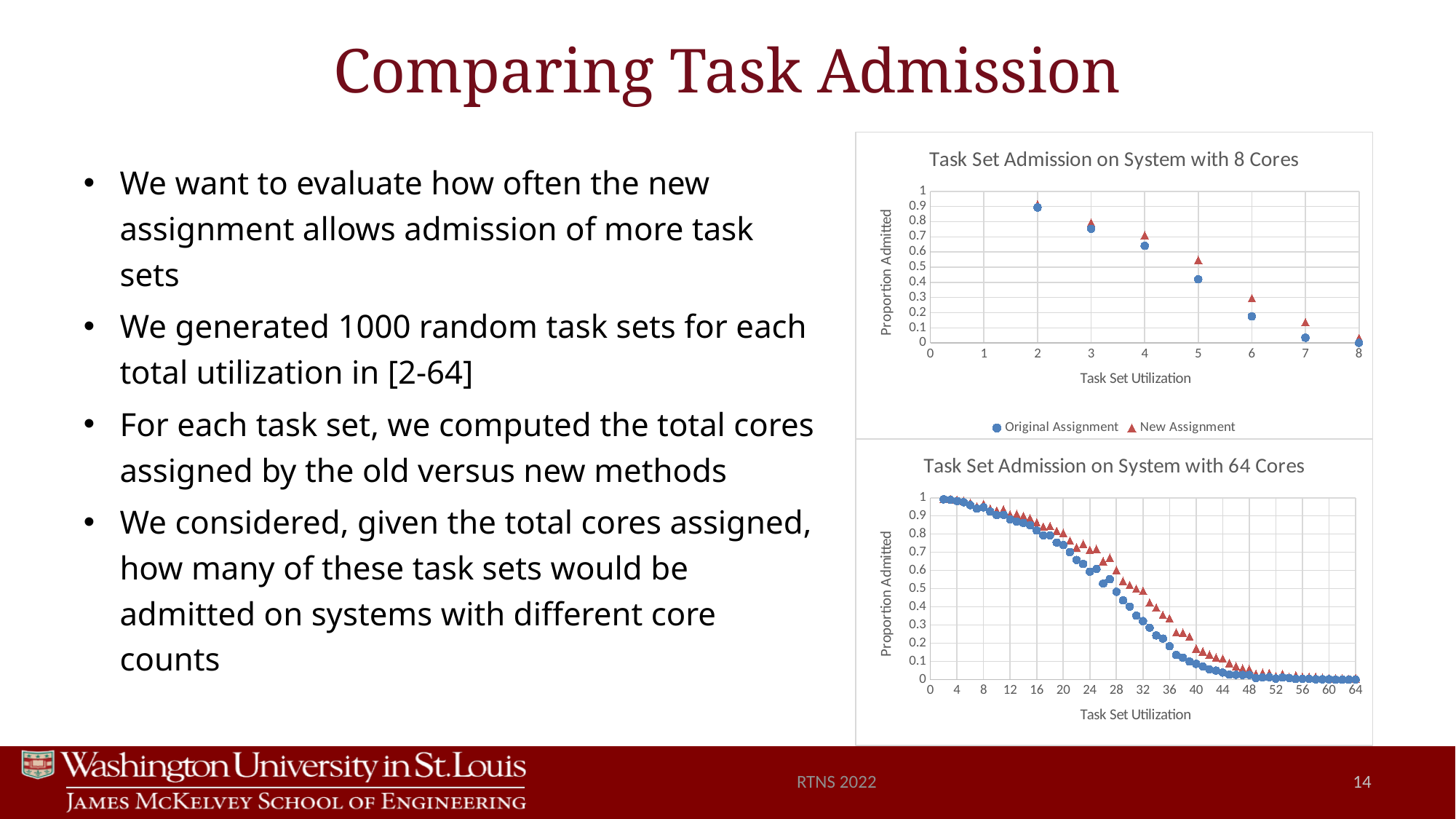
In the 'Task Set Admission on System with 8 Cores' chart, which series has the higher proportion admitted at task set utilization 5? New Assignment In the 'Task Set Admission on System with 8 Cores' chart, do the Original Assignment values rise or fall as task set utilization increases? fall In the 'Task Set Admission on System with 8 Cores' chart, how many task set utilization values are plotted for the Original Assignment series? 7 In the 'Task Set Admission on System with 8 Cores' chart, is the Original Assignment value at task set utilization 4 greater or less than 0.5? greater In the 'Task Set Admission on System with 8 Cores' chart, at which task set utilization is the Original Assignment proportion admitted highest? 2 In the 'Task Set Admission on System with 8 Cores' chart, is the Original Assignment value at task set utilization 5 greater or less than 0.5? less In the 'Task Set Admission on System with 8 Cores' chart, is the New Assignment value at task set utilization 6 greater or less than 0.2? greater What is the x-axis title of the 'Task Set Admission on System with 64 Cores' chart? Task Set Utilization In the 'Task Set Admission on System with 64 Cores' chart, do the values rise or fall as task set utilization increases? fall What kind of chart is the 'Task Set Admission on System with 8 Cores' chart? scatter chart How many series does the legend of the 'Task Set Admission on System with 8 Cores' chart list? 2